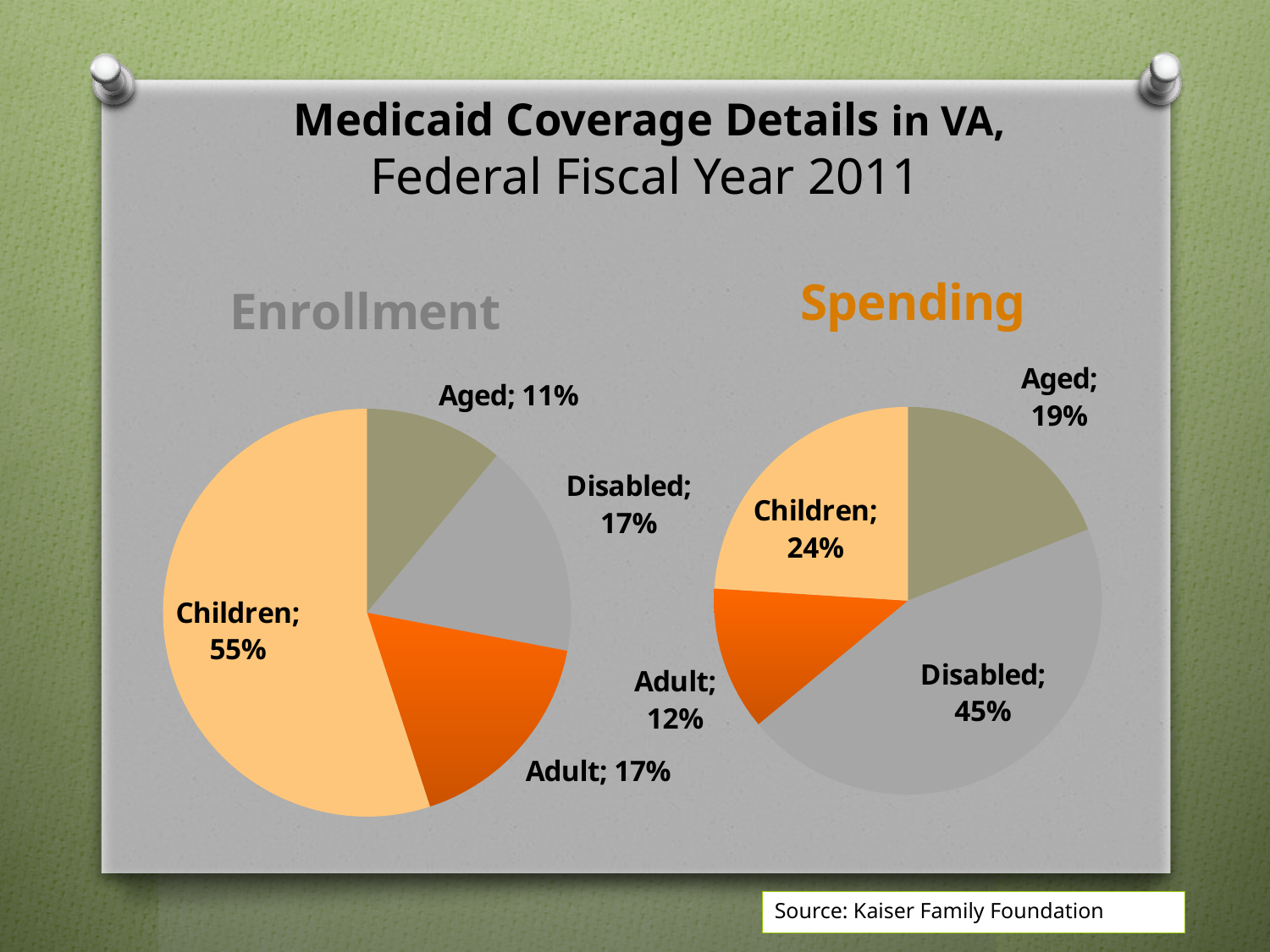
What type of chart is used for Spending? Pie chart What is the difference between the Disabled share in the Spending chart and the Disabled share in the Enrollment chart? 28% In the Enrollment pie chart, what share of enrollment is Children? 55% In the Enrollment pie chart, which category has the largest slice? Children In the Spending pie chart, what is the value for Adult? 12% How many categories does the Enrollment pie chart show? 4 In the Spending pie chart, what share of spending is Disabled? 45% In the Enrollment pie chart, what is the value for Aged? 11% In the Spending pie chart, which category has the smallest slice? Adult In the Spending pie chart, which is larger: Children or Aged? Children What is the title of the slide containing the two charts? Medicaid Coverage Details in VA, Federal Fiscal Year 2011 In the Enrollment pie chart, which category has the smallest slice? Aged